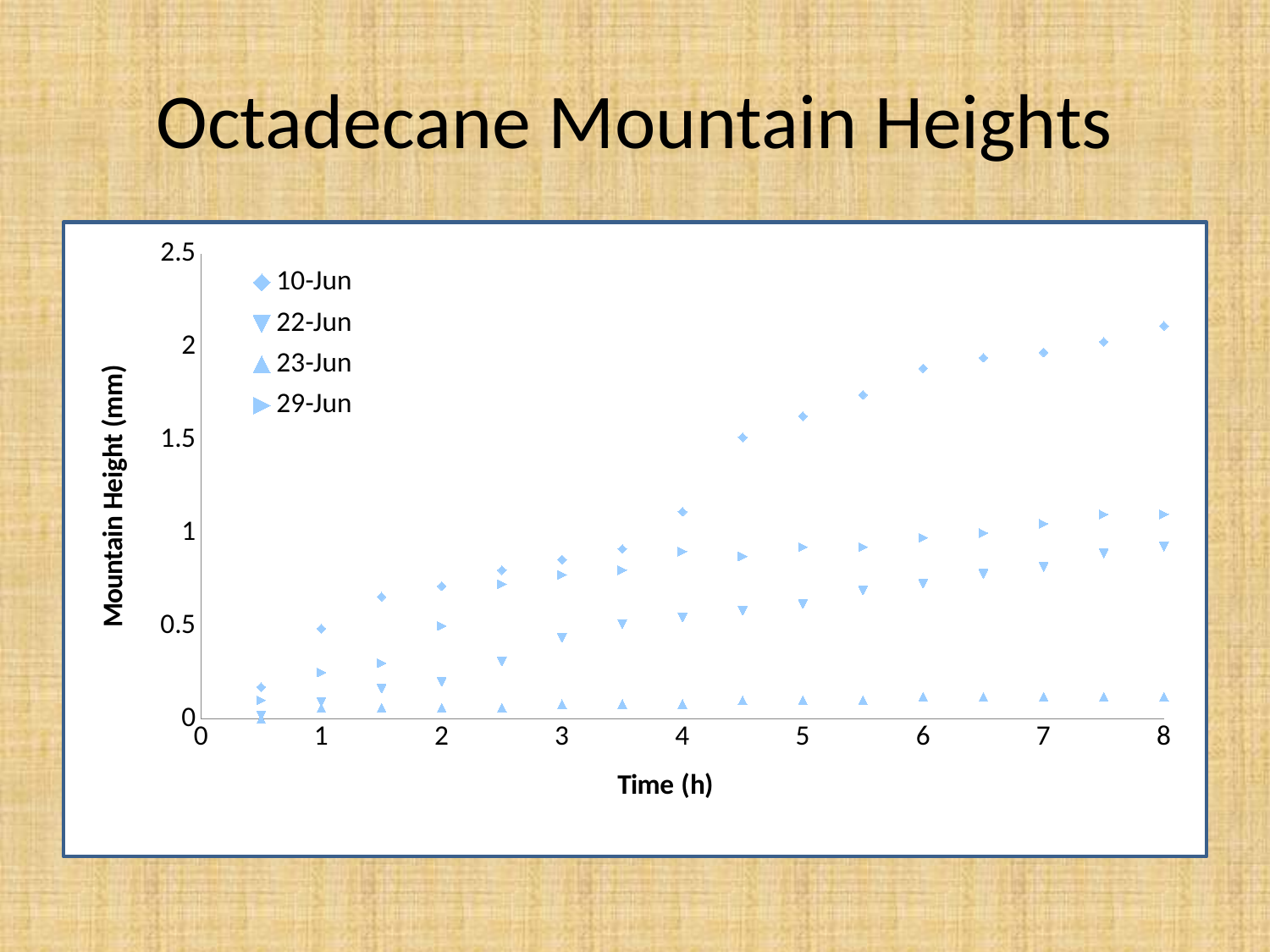
Is the value for 10-Jun at 8 h greater or less than 2? greater Is the value for 23-Jun at 8 h greater or less than 0.5? less Which series has the lowest mountain height at 8 h? 23-Jun At 8 h, which series has the larger value, 22-Jun or 23-Jun? 22-Jun Is the value for 10-Jun at 6 h greater or less than 1.5? greater What kind of chart is shown on the slide? Scatter chart How many series does the legend list? 4 Does the mountain height for 10-Jun rise or fall as time increases? Rise At 8 h, which series has the larger value, 10-Jun or 29-Jun? 10-Jun What is the label of the vertical axis? Mountain Height (mm) What is the title of the chart? Octadecane Mountain Heights Which series has the highest mountain height at 8 h? 10-Jun